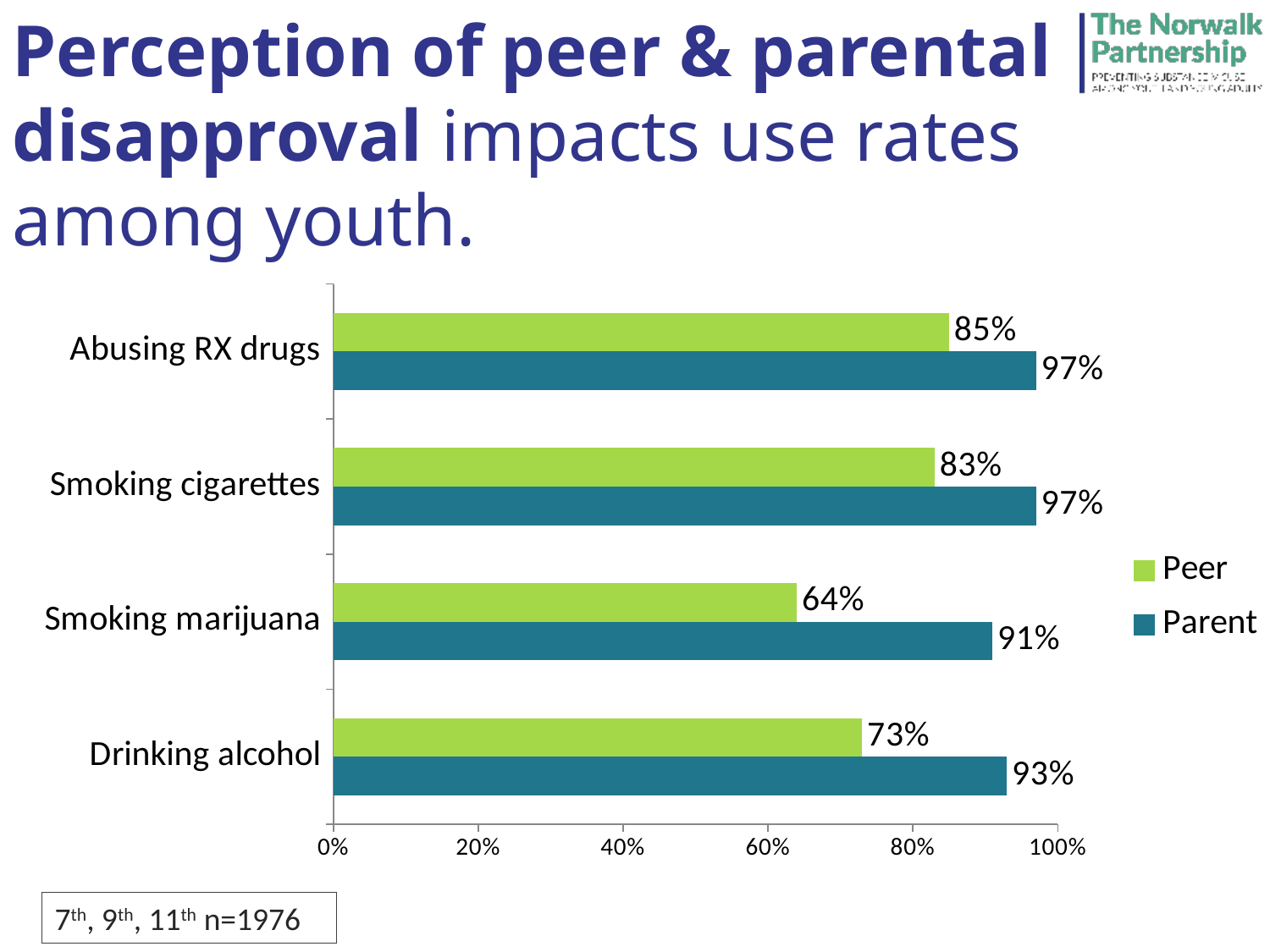
What is the difference between the Parent and Peer values for Smoking marijuana? 27% What is the difference between the Peer values for Abusing RX drugs and Smoking cigarettes? 2% What is the Peer value for Smoking marijuana? 64% Which category has the highest Peer value? Abusing RX drugs Which colour represents the Parent series in the legend? Teal (dark blue-green) What is the Parent value for Drinking alcohol? 93% How many categories are shown on the chart? 4 What kind of chart is shown on the slide? Bar chart How many series does the legend list? 2 Which is larger, the Peer value for Drinking alcohol or the Peer value for Smoking marijuana? Drinking alcohol Which category has the lowest Peer value? Smoking marijuana What is the Peer value for Abusing RX drugs? 85%